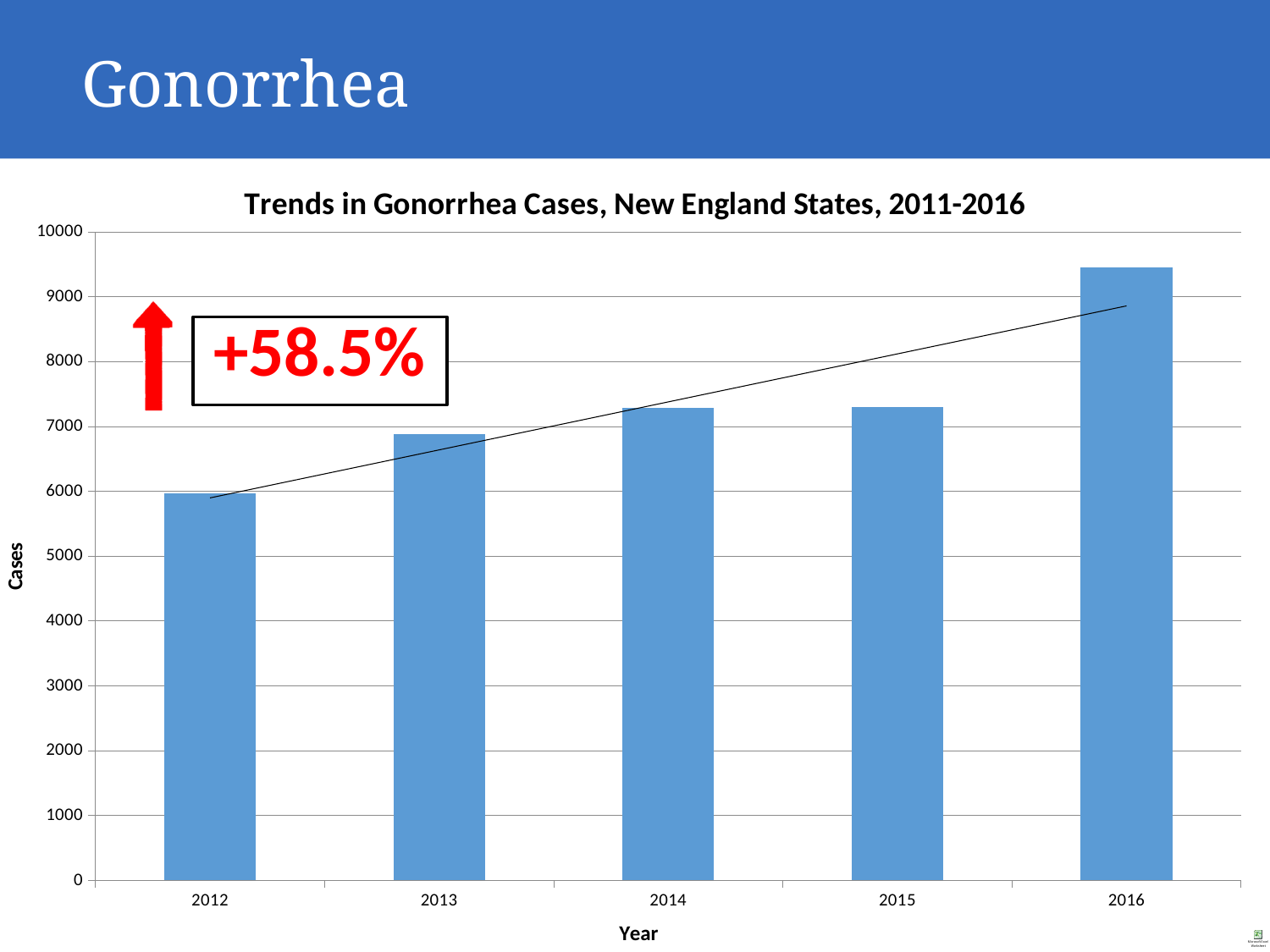
Which year has the highest number of cases? 2016 Is the value for 2016 greater or less than 2013? greater What percentage change is shown in the annotation box on the chart? +58.5% Do the number of cases generally rise or fall from 2012 to 2016? rise Is the value for 2013 greater or less than 7000? less Which year has the lowest number of cases? 2012 What is the title of the chart? Trends in Gonorrhea Cases, New England States, 2011-2016 Is the value for 2014 greater or less than 7000? greater How many years are plotted on the x axis of the chart? 5 Is the value for 2016 greater or less than 9000? greater What kind of chart is shown on the slide? bar chart